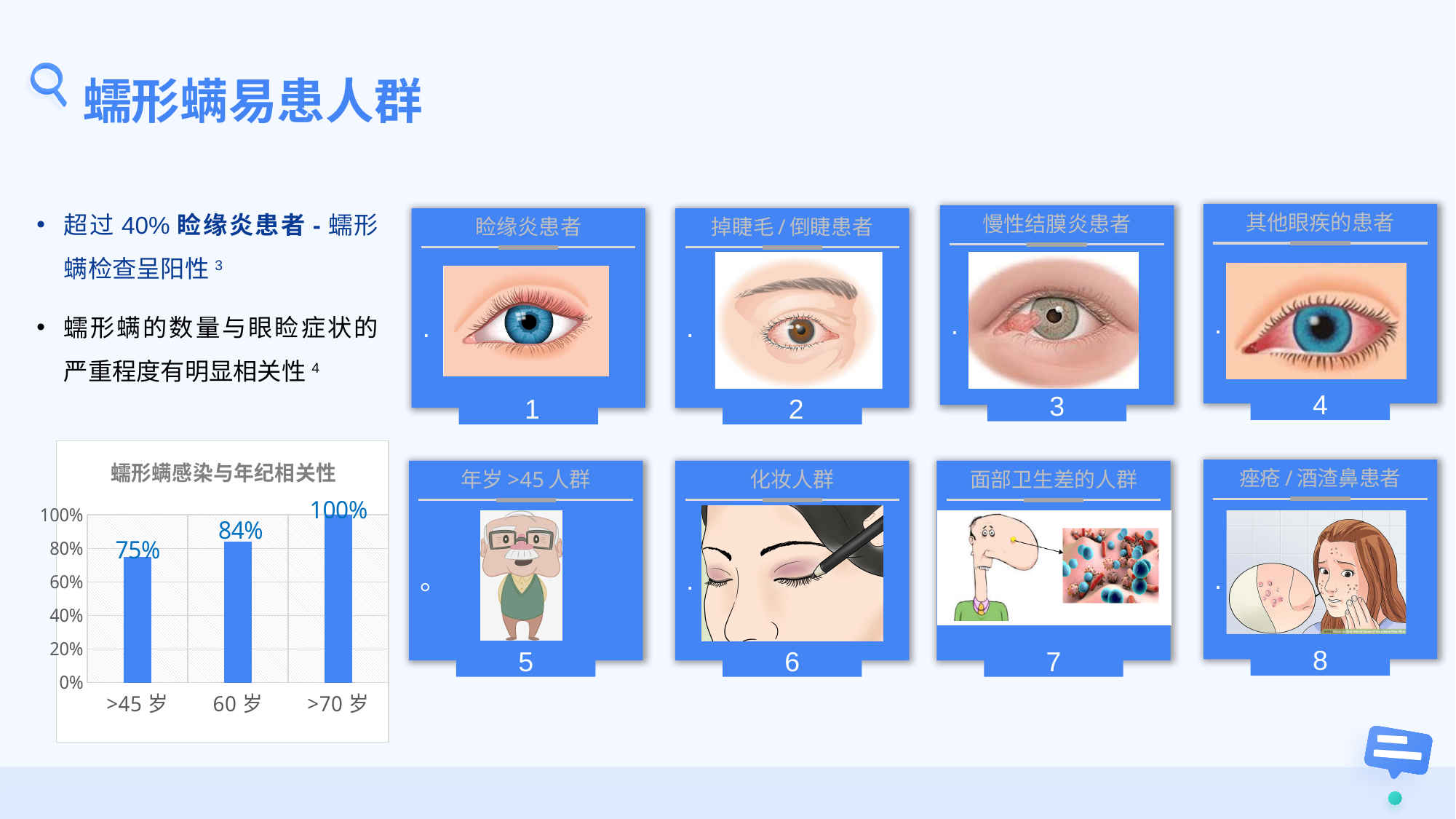
What is the value for 60 岁 in the chart? 84% What is the value for >45 岁 in the chart? 75% What is the title of the chart? 蠕形螨感染与年纪相关性 What is the difference between the values for 60 岁 and >45 岁? 9% What kind of chart is shown on the slide? bar chart What is the value for >70 岁 in the chart? 100% Which is larger, the value for 60 岁 or the value for >45 岁? 60 岁 Which age group has the lowest value in the chart? >45 岁 How many age categories are shown in the chart? 3 Which age group has the highest value in the chart? >70 岁 What is the difference between the values for >70 岁 and >45 岁? 25% Is the value for 60 岁 greater or less than 80%? greater